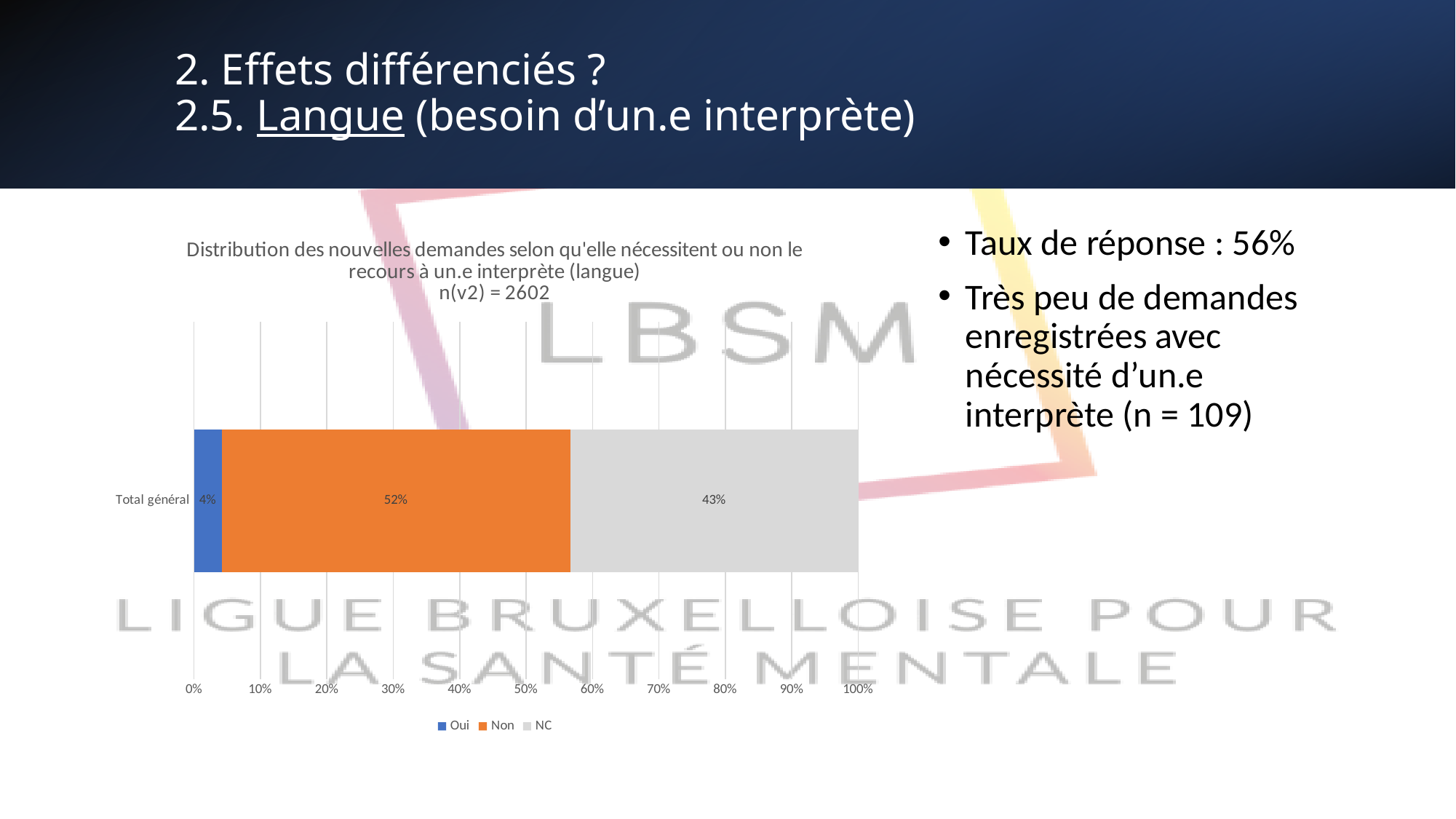
How many series does the legend list? 3 Which is larger, the value for Non or the value for NC? Non What kind of chart is shown? Stacked bar chart Is the value for Non greater or less than 50%? greater How many categories are shown on the vertical axis? 1 What is the value for Oui in the Total général bar? 4% What is the value for NC in the Total général bar? 43% What is the value for Non in the Total général bar? 52% Which series has the largest share of the Total général bar? Non Which series has the smallest share of the Total général bar? Oui What is the n(v2) value stated in the chart title? 2602 What is the difference between the Non and NC values? 9%